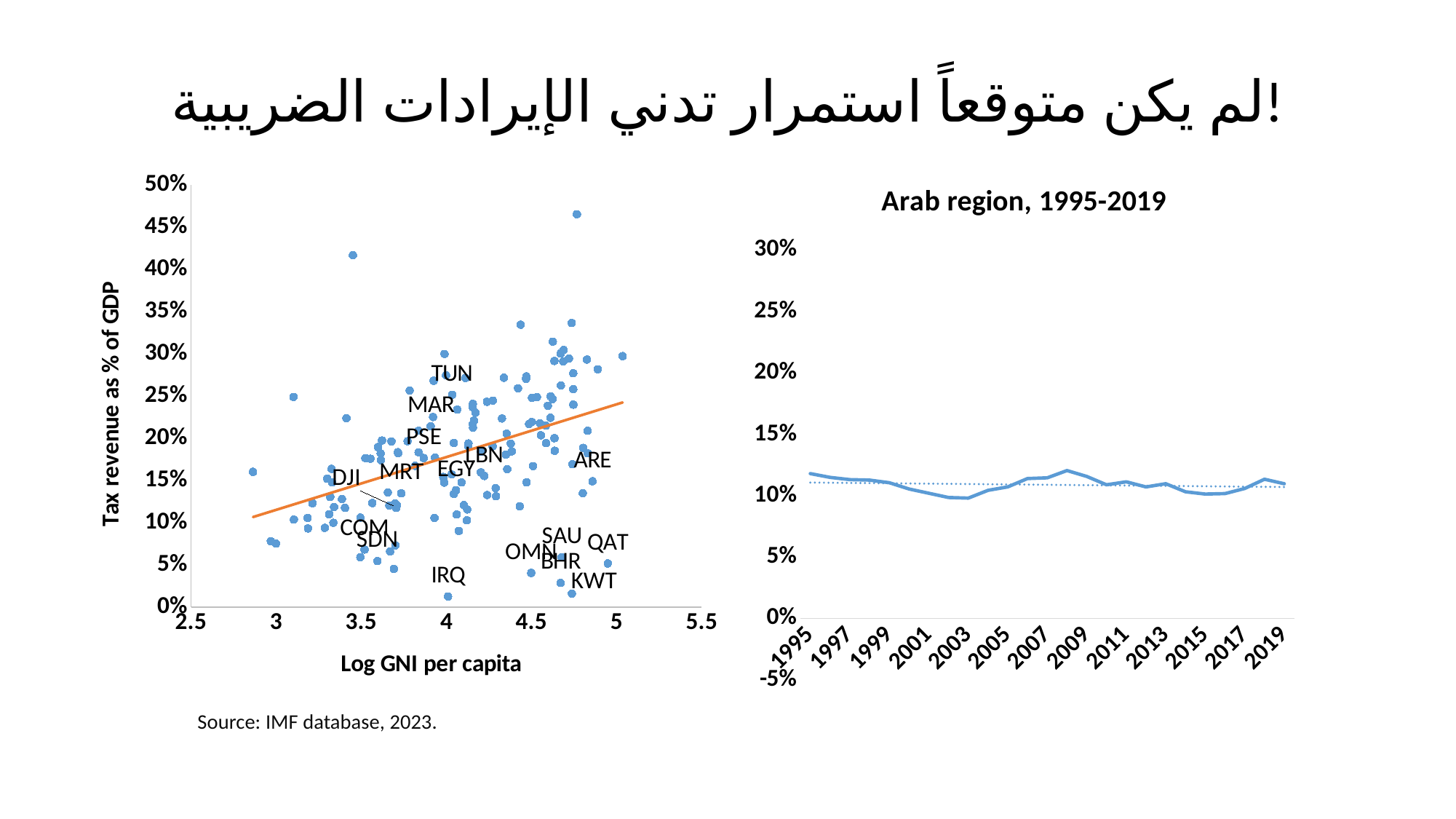
In the right chart 'Arab region, 1995-2019', is the value for 1995 greater or less than 20%? less In the left scatter plot, does the orange trend line rise or fall as Log GNI per capita increases? rises What kind of chart is the right chart titled 'Arab region, 1995-2019'? line chart In the left scatter plot, is the point labelled KWT greater or less than 10% tax revenue as % of GDP? less In the left scatter plot, is the highest plotted point greater or less than 40% tax revenue as % of GDP? greater In the left scatter plot, which labelled country is plotted higher on the y axis, TUN or IRQ? TUN What kind of chart is the left chart on the slide? scatter plot In the right chart 'Arab region, 1995-2019', what is the first year shown on the x axis? 1995 In the left scatter plot, what is the label of the y axis? Tax revenue as % of GDP In the left scatter plot, what is the label of the x axis? Log GNI per capita